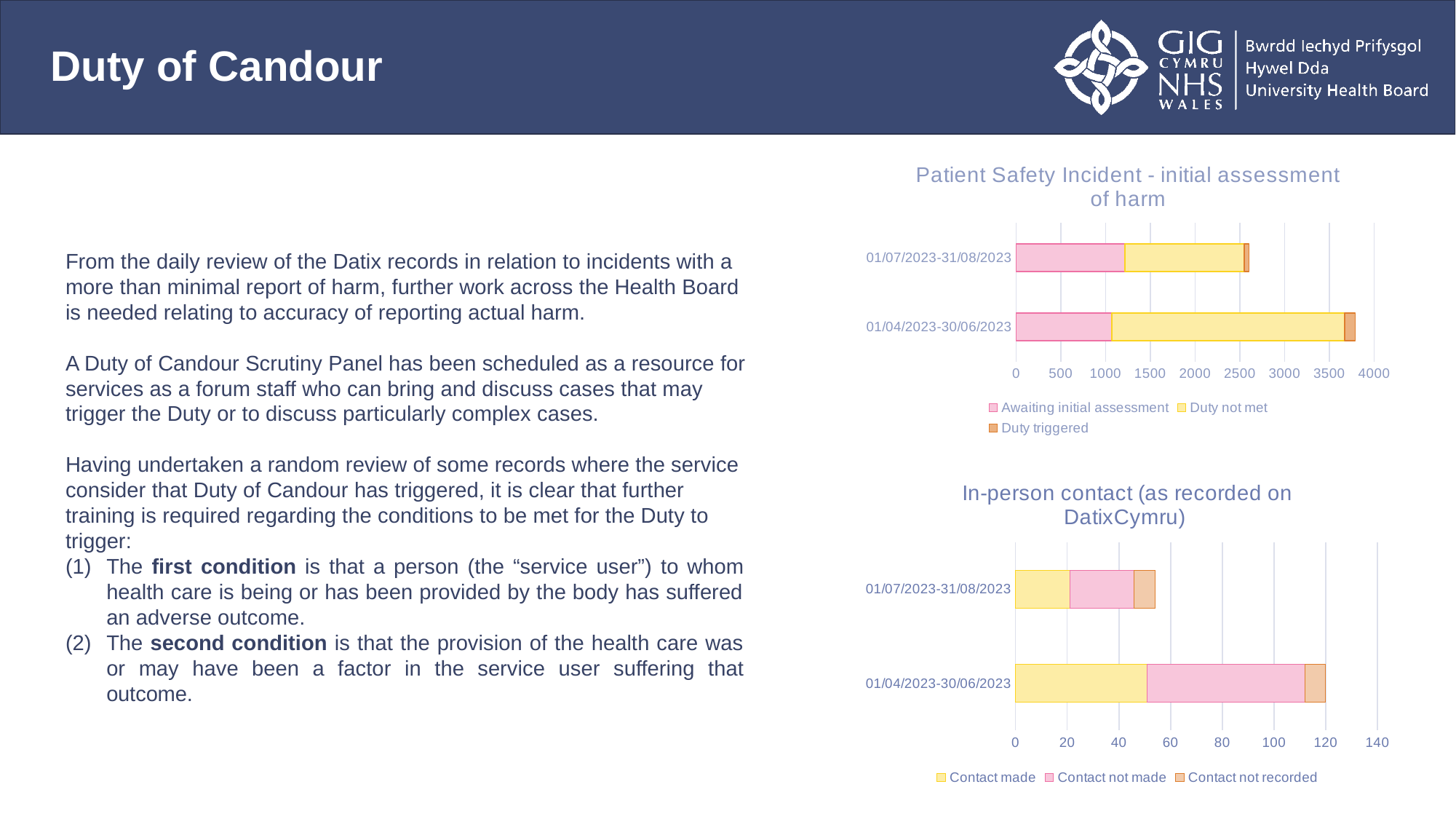
In the 'Patient Safety Incident - initial assessment of harm' chart, which series is shown in pink? Awaiting initial assessment In the 'In-person contact (as recorded on DatixCymru)' chart, is the total bar length for 01/07/2023-31/08/2023 greater or less than 80? less How many time periods are shown on the 'Patient Safety Incident - initial assessment of harm' chart? 2 In the 'Patient Safety Incident - initial assessment of harm' chart, is the total bar length for 01/07/2023-31/08/2023 greater or less than 3000? less In the 'Patient Safety Incident - initial assessment of harm' chart, which period has the longer total bar? 01/04/2023-30/06/2023 How many series does the legend of the 'In-person contact (as recorded on DatixCymru)' chart list? 3 How many series does the legend of the 'Patient Safety Incident - initial assessment of harm' chart list? 3 In the 'In-person contact (as recorded on DatixCymru)' chart, which period has the longer total bar? 01/04/2023-30/06/2023 In the 'Patient Safety Incident - initial assessment of harm' chart, is the total bar length for 01/04/2023-30/06/2023 greater or less than 3500? greater What type of chart is the 'Patient Safety Incident - initial assessment of harm' chart? Stacked bar chart What is the maximum value shown on the x axis of the 'In-person contact (as recorded on DatixCymru)' chart? 140